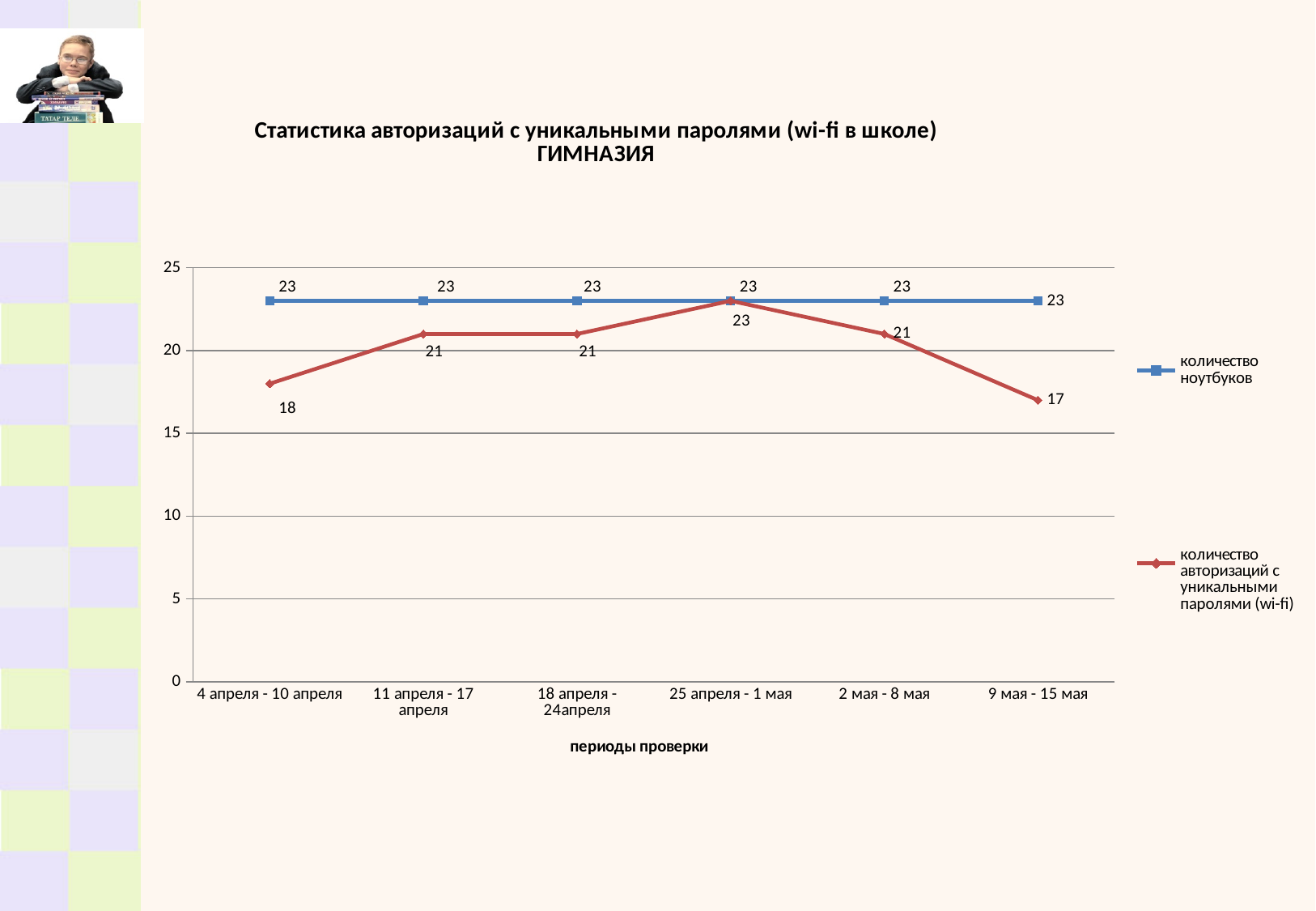
In which period is the value of 'количество авторизаций с уникальными паролями (wi-fi)' the lowest? 9 мая - 15 мая In which period is the value of 'количество авторизаций с уникальными паролями (wi-fi)' the highest? 25 апреля - 1 мая How many check periods are shown on the x axis? 6 What is the difference between 'количество ноутбуков' and 'количество авторизаций с уникальными паролями (wi-fi)' for the period '4 апреля - 10 апреля'? 5 What is the value of 'количество авторизаций с уникальными паролями (wi-fi)' for the period '4 апреля - 10 апреля'? 18 Does the value of 'количество авторизаций с уникальными паролями (wi-fi)' rise or fall from '25 апреля - 1 мая' to '9 мая - 15 мая'? fall What kind of chart is shown on the slide? line chart What is the value of 'количество авторизаций с уникальными паролями (wi-fi)' for the period '9 мая - 15 мая'? 17 How many series does the legend list? 2 What is the x-axis title of the chart? периоды проверки What is the value of 'количество ноутбуков' for the period '25 апреля - 1 мая'? 23 Which is larger for the period '2 мая - 8 мая': 'количество ноутбуков' or 'количество авторизаций с уникальными паролями (wi-fi)'? количество ноутбуков